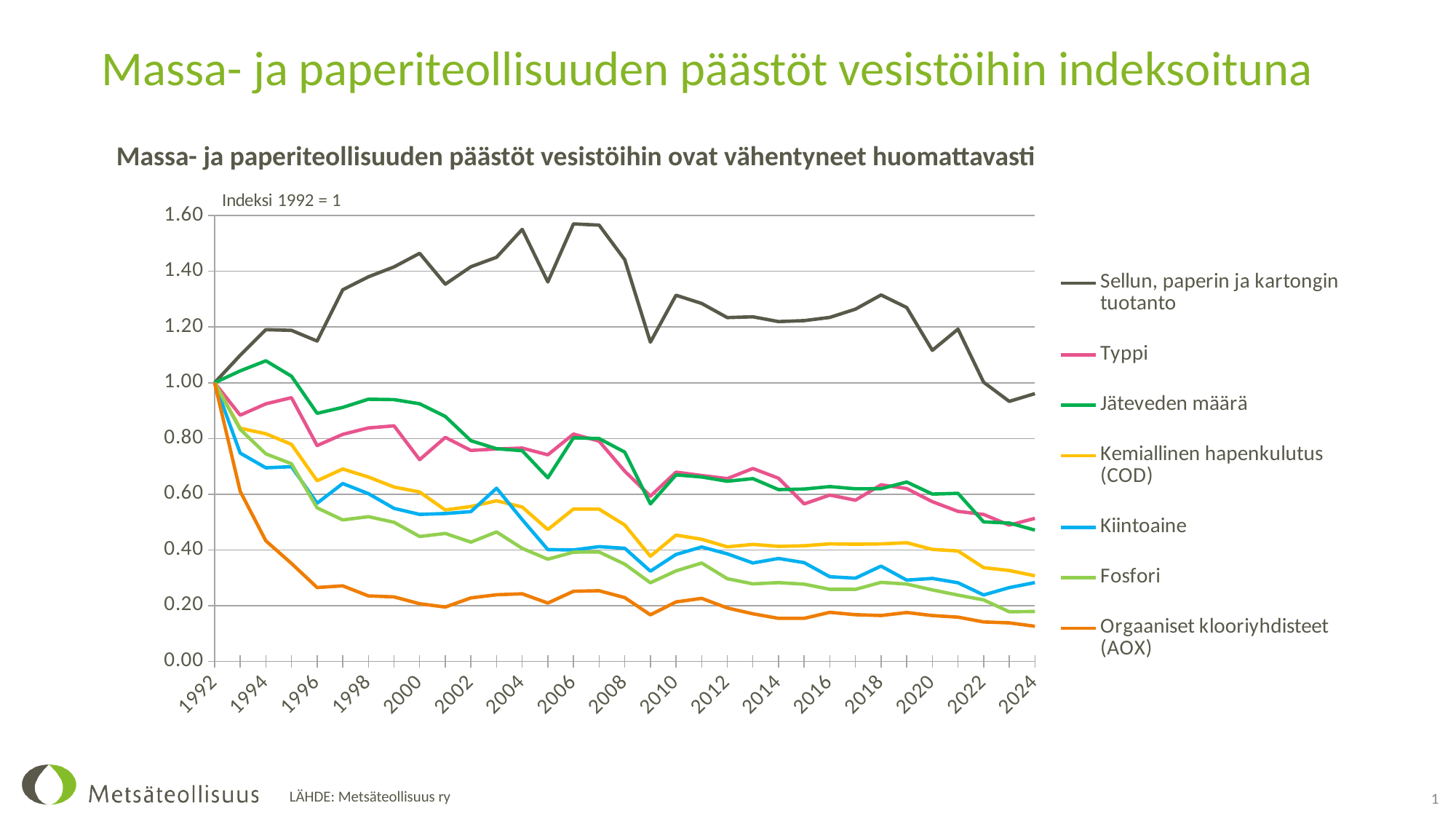
In 2010, which is larger: Jäteveden määrä or Kiintoaine? Jäteveden määrä Does the Kemiallinen hapenkulutus (COD) line rise or fall from 1992 to 2024? fall What is the title of the chart? Massa- ja paperiteollisuuden päästöt vesistöihin ovat vähentyneet huomattavasti Which series has the highest value in 2024? Sellun, paperin ja kartongin tuotanto Is the value for Sellun, paperin ja kartongin tuotanto in 2006 greater or less than 1.40? greater Is the value for Typpi in 2000 greater or less than 0.80? less What is the last year shown on the x axis? 2024 Which series has the lowest value in 2024? Orgaaniset klooriyhdisteet (AOX) What kind of chart is shown on the slide? line chart What is the index value of Typpi in 1992? 1.00 Is the value for Orgaaniset klooriyhdisteet (AOX) in 2024 greater or less than 0.20? less How many series does the legend list? 7